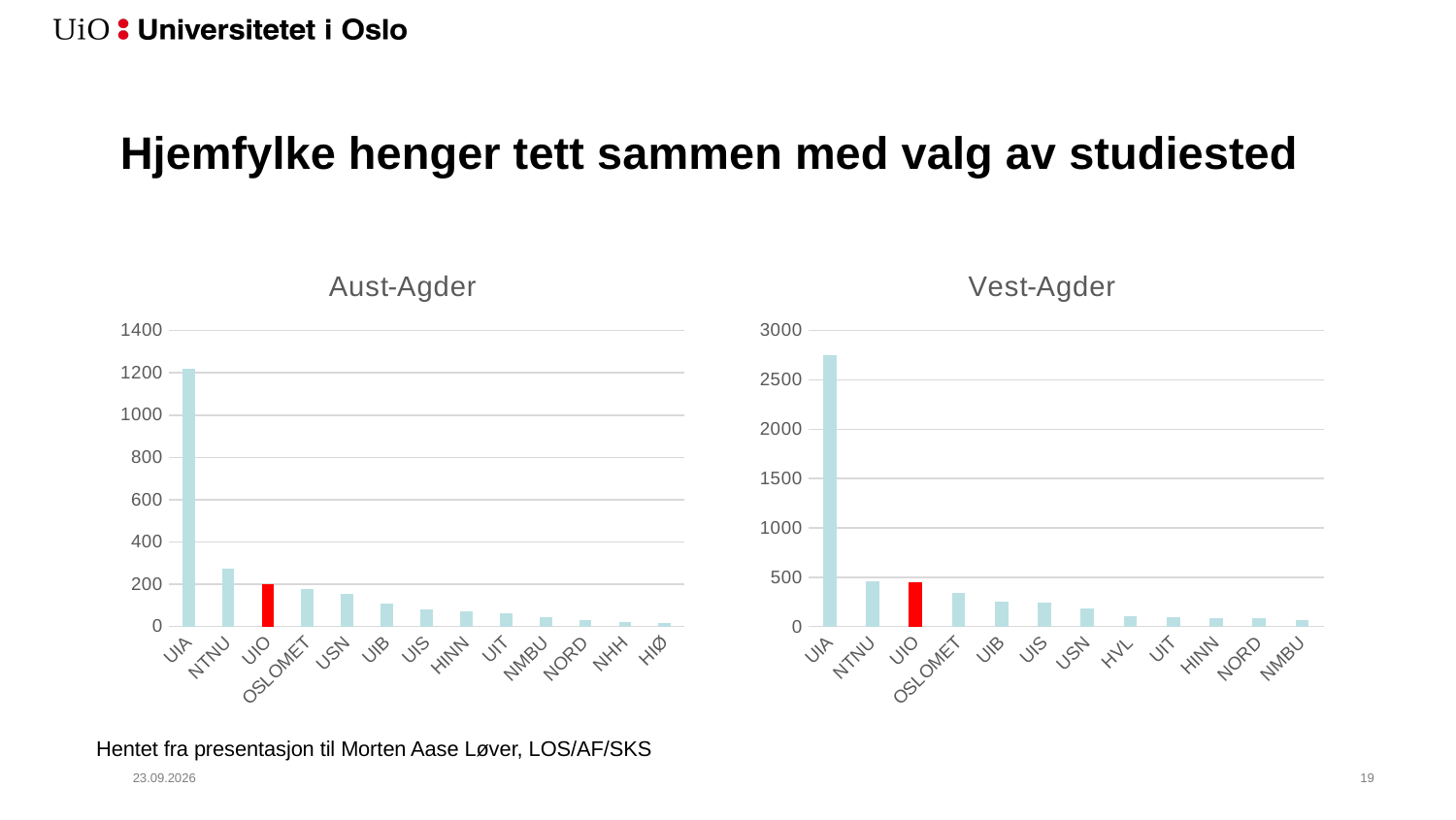
What kind of chart is the Aust-Agder chart? bar chart In the Vest-Agder chart, which institution has the highest value? UIA In the Aust-Agder chart, which is larger, the value for NTNU or the value for UIO? NTNU In the Vest-Agder chart, which bar is coloured red? UIO In the Vest-Agder chart, is the value for UIA greater or less than 2500? greater In the Aust-Agder chart, is the value for UIA greater or less than 1000? greater How many institutions are shown on the x axis of the Aust-Agder chart? 13 In the Aust-Agder chart, which institution has the highest value? UIA How many institutions are shown on the x axis of the Vest-Agder chart? 12 In the Aust-Agder chart, which institution has the lowest value? HIØ In the Vest-Agder chart, which institution has the lowest value? NMBU